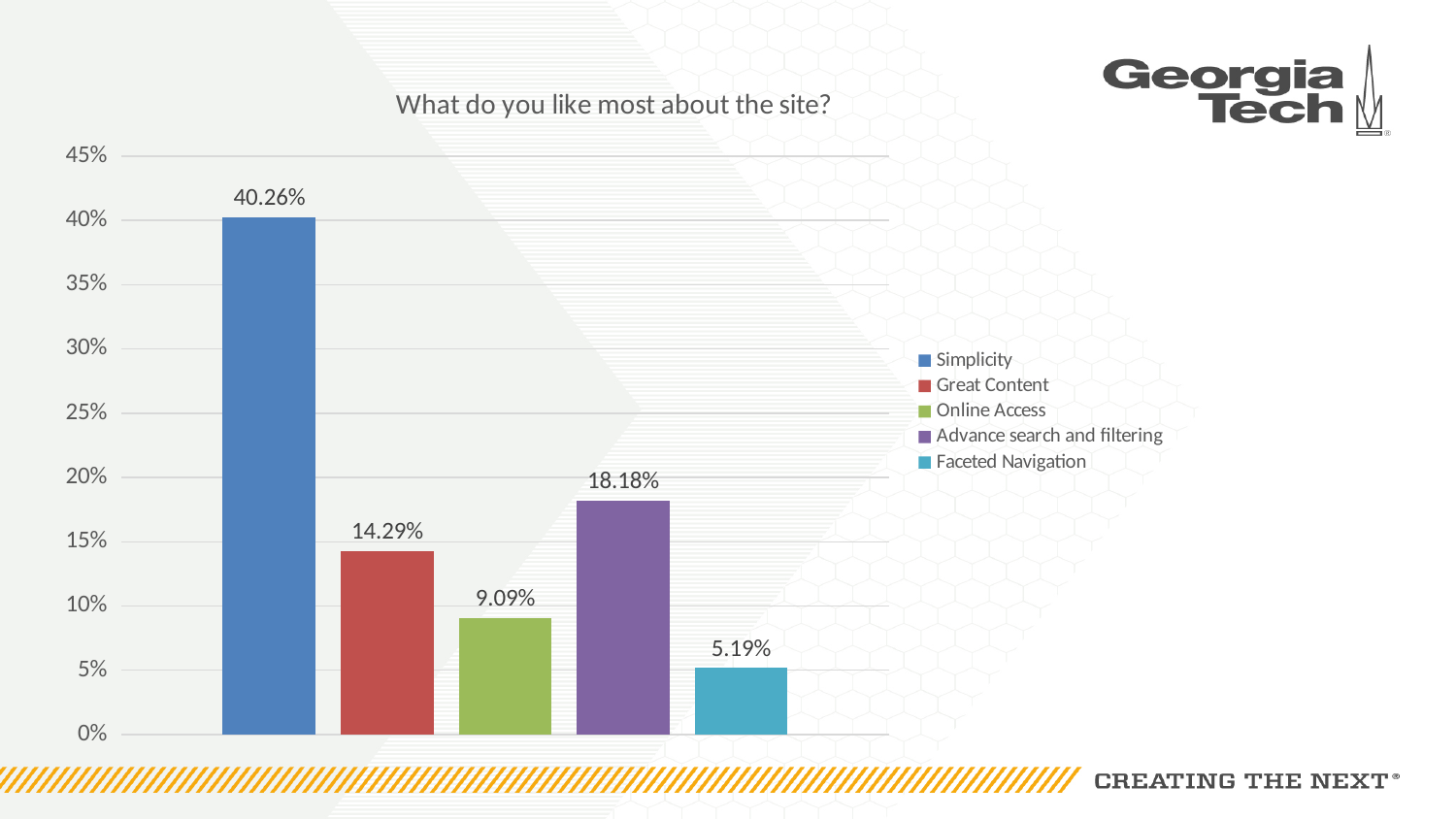
Which category has the highest value? Simplicity Which category has the lowest value? Faceted Navigation What kind of chart is shown on the slide? Bar chart Which is larger, the value for Great Content or the value for Online Access? Great Content How many categories are shown in the chart? 5 What is the value for Faceted Navigation? 5.19% What is the value for Simplicity? 40.26% What is the difference between the values for Simplicity and Advance search and filtering? 22.08% What is the value for Online Access? 9.09% What is the value for Great Content? 14.29% What is the title of the chart? What do you like most about the site? What is the value for Advance search and filtering? 18.18%